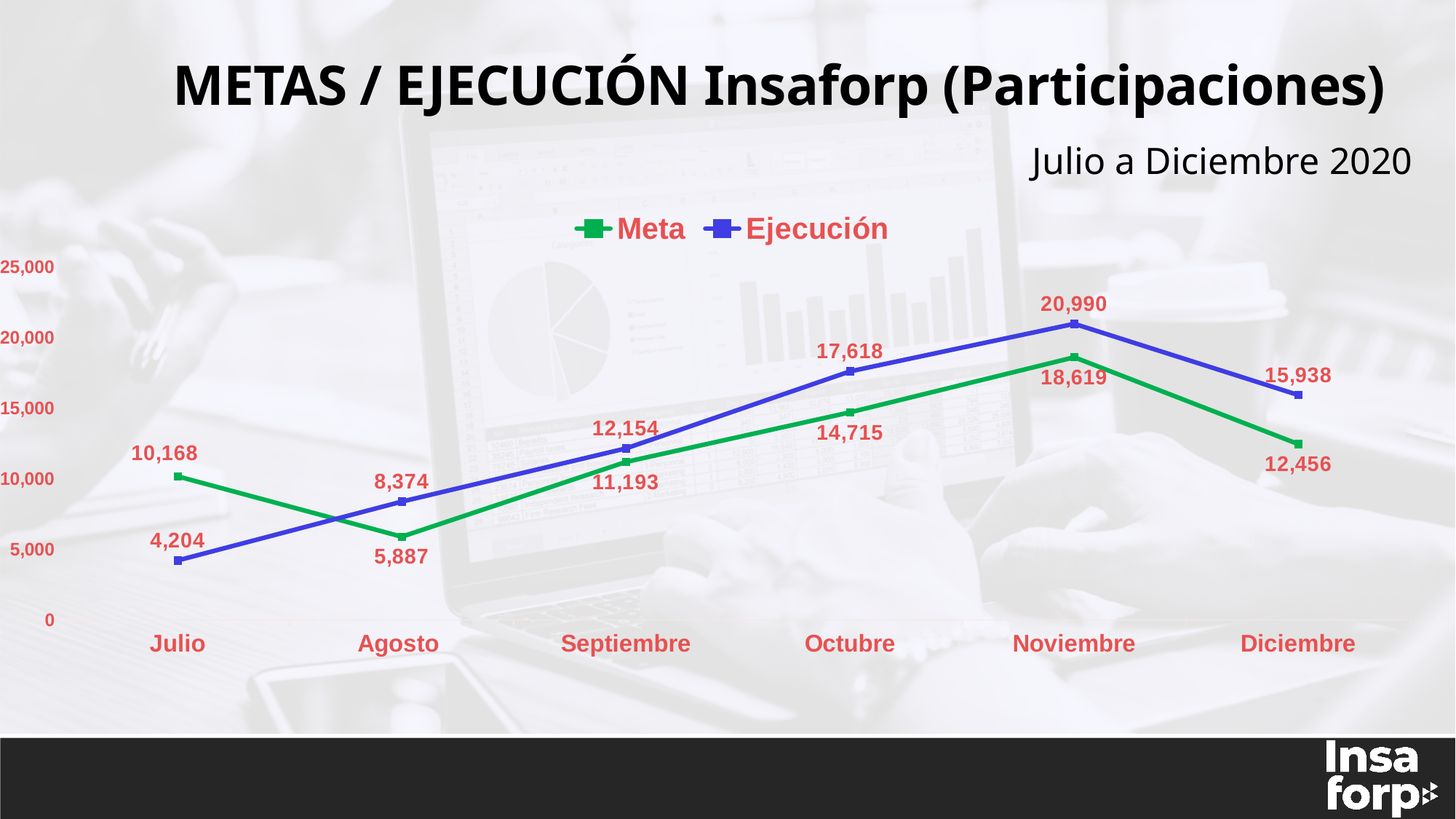
In which month is the Ejecución value highest? Noviembre Does the Ejecución line rise or fall from Julio to Noviembre? Rise What is the Meta value for Diciembre? 12,456 What colour is the Ejecución line? Blue Which is larger in Julio, Meta or Ejecución? Meta In which month is the Meta value lowest? Agosto How many months are plotted on the x axis? 6 What is the Meta value for Julio? 10,168 What is the difference between Ejecución and Meta in Noviembre? 2,371 How many series does the legend list? 2 What type of chart is shown on the slide? Line chart What is the Ejecución value for Octubre? 17,618